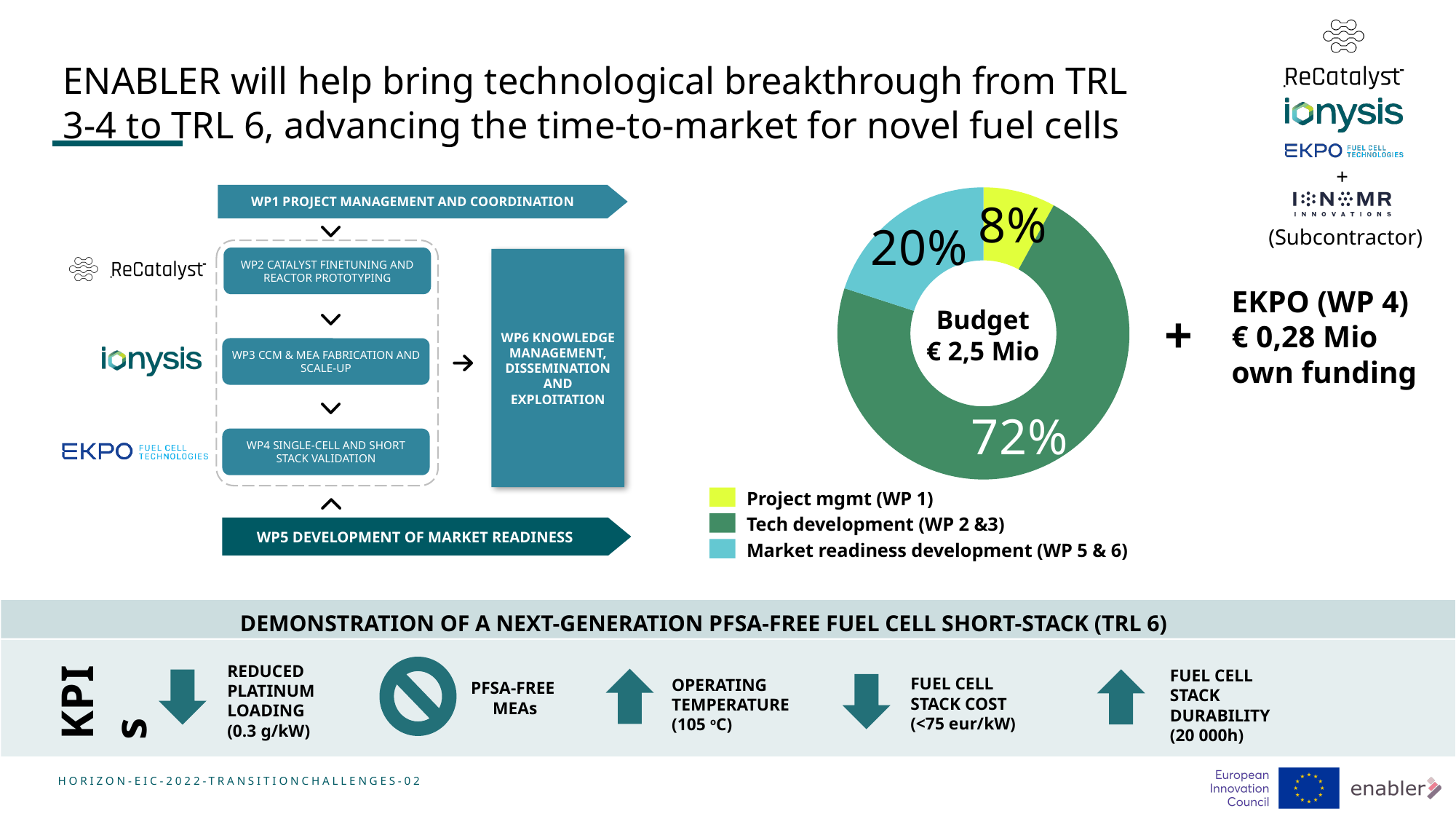
How many categories does the budget chart show? 3 How many entries does the legend of the budget chart list? 3 Which category has the largest share of the budget? Tech development (WP 2 & 3) Which category has the smallest share of the budget? Project mgmt (WP 1) Which is larger: the share for Market readiness development (WP 5 & 6) or the share for Project mgmt (WP 1)? Market readiness development (WP 5 & 6) What total budget is shown in the centre of the chart? € 2,5 Mio What share of the budget goes to Tech development (WP 2 & 3)? 72% What share of the budget goes to Market readiness development (WP 5 & 6)? 20% What kind of chart is used to show the budget breakdown? Pie chart (donut) What share of the budget goes to Project mgmt (WP 1)? 8% What colour is the Project mgmt (WP 1) slice in the budget chart? Yellow-green What is the difference in percentage points between the Tech development share and the Market readiness development share? 52